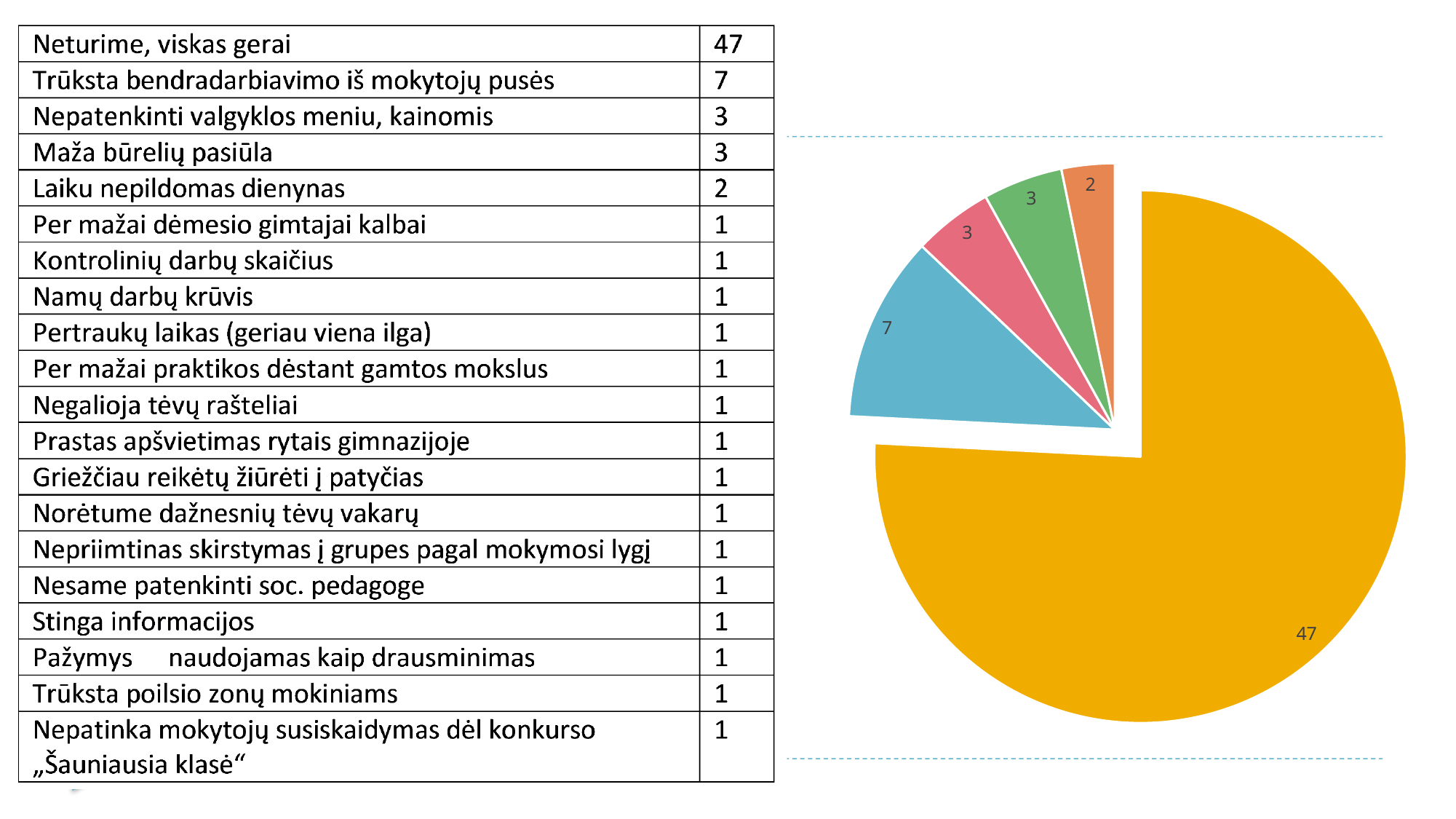
Which slice is larger in the pie chart, the blue slice or the orange slice? the blue slice Does the pie chart have a legend? No What value is labelled on the green slice of the pie chart? 3 What kind of chart is shown on the right side of the slide? pie chart What is the total of all the slice values in the pie chart? 62 What colour is the largest slice of the pie chart? yellow How many slices does the pie chart have? 5 What is the value of the smallest slice in the pie chart? 2 What value is labelled on the blue slice of the pie chart? 7 What is the value of the largest slice in the pie chart? 47 What is the difference between the largest slice (47) and the blue slice (7) in the pie chart? 40 What value is labelled on the orange slice of the pie chart? 2